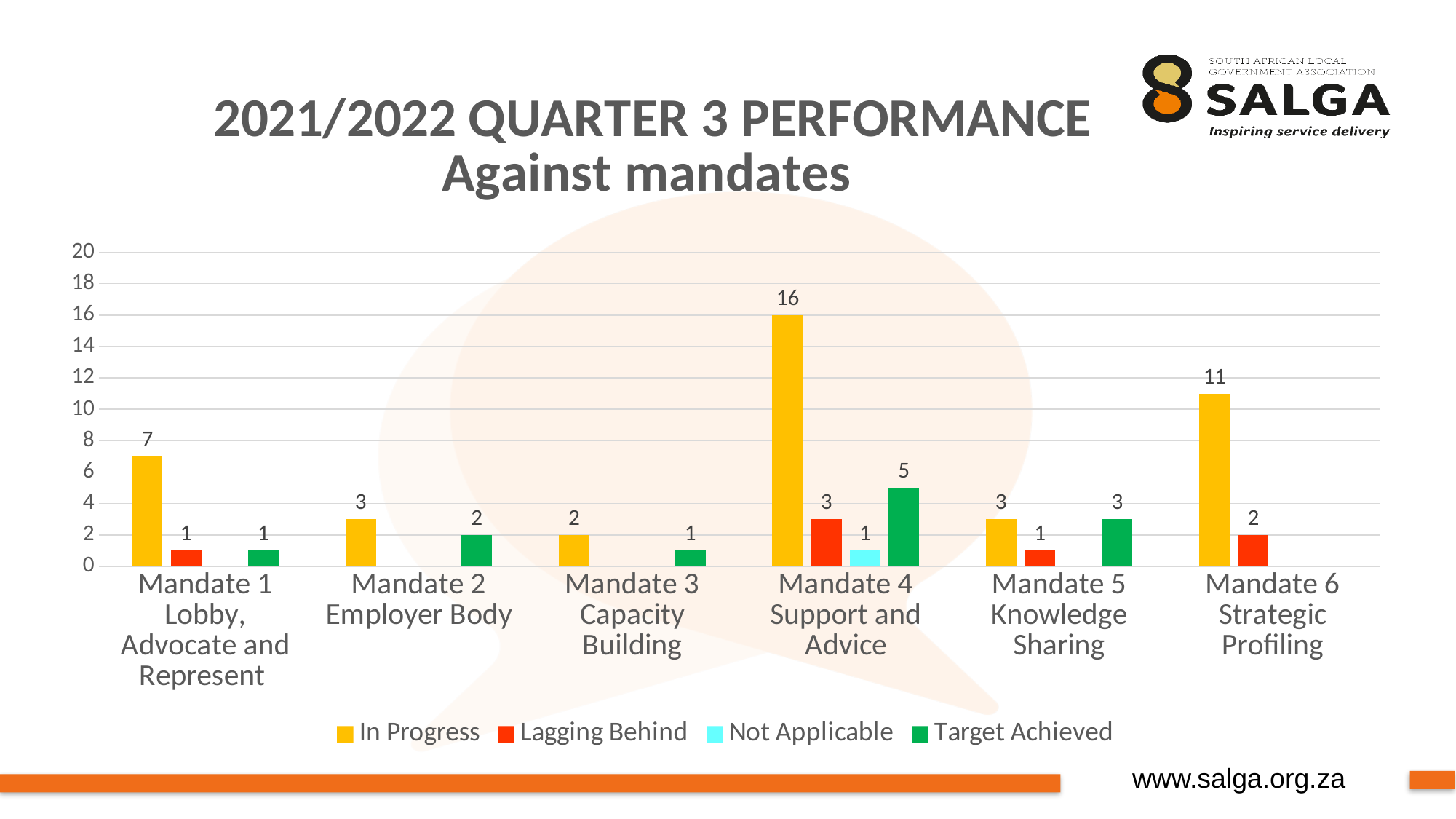
How many series does the legend list? 4 Which mandate has the highest Target Achieved value? Mandate 4 Support and Advice Which mandate has the highest In Progress value? Mandate 4 Support and Advice What is the In Progress value for Mandate 4 Support and Advice? 16 What is the Lagging Behind value for Mandate 6 Strategic Profiling? 2 What is the difference between the In Progress values for Mandate 4 Support and Advice and Mandate 6 Strategic Profiling? 5 What is the Not Applicable value for Mandate 4 Support and Advice? 1 What kind of chart is shown on the slide? Bar chart Which is larger, the In Progress value for Mandate 1 Lobby, Advocate and Represent or the In Progress value for Mandate 2 Employer Body? Mandate 1 Lobby, Advocate and Represent Is the In Progress value for Mandate 6 Strategic Profiling greater or less than 10? greater What is the Target Achieved value for Mandate 5 Knowledge Sharing? 3 How many mandates are shown on the x axis? 6